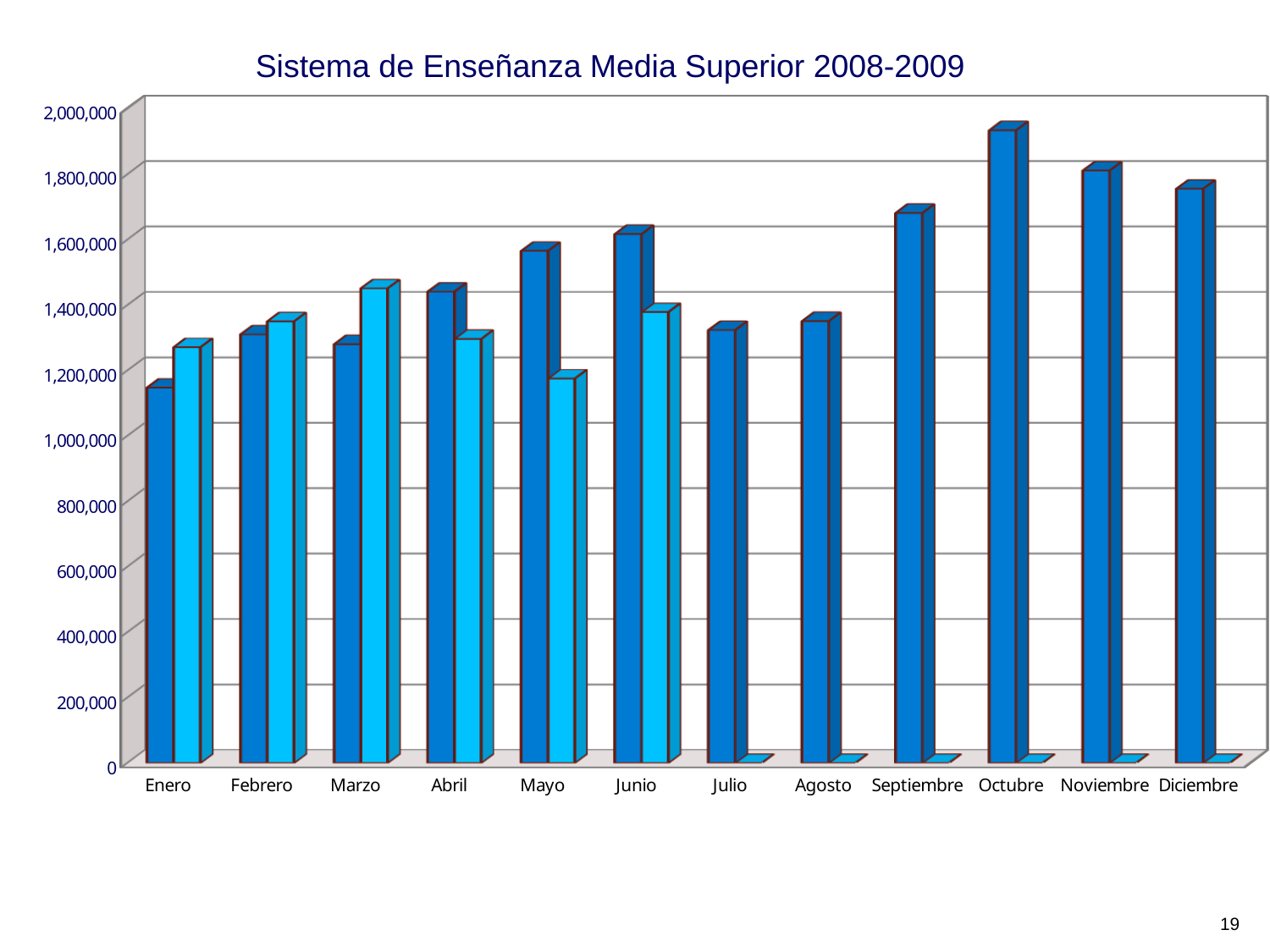
Is the dark blue bar for Octubre greater or less than 1,800,000? greater Which month has the tallest dark blue bar? Octubre What kind of chart is shown on the slide? bar chart Is the dark blue bar for Enero greater or less than 1,200,000? less How many months are shown on the x axis of the chart? 12 Which month has the shortest dark blue bar? Enero Is the dark blue bar for Julio greater or less than 1,400,000? less Which is taller in Marzo, the dark blue bar or the light blue bar? the light blue bar What is the title of the chart? Sistema de Enseñanza Media Superior 2008-2009 Which is taller in Mayo, the dark blue bar or the light blue bar? the dark blue bar Which month has the tallest light blue bar? Marzo